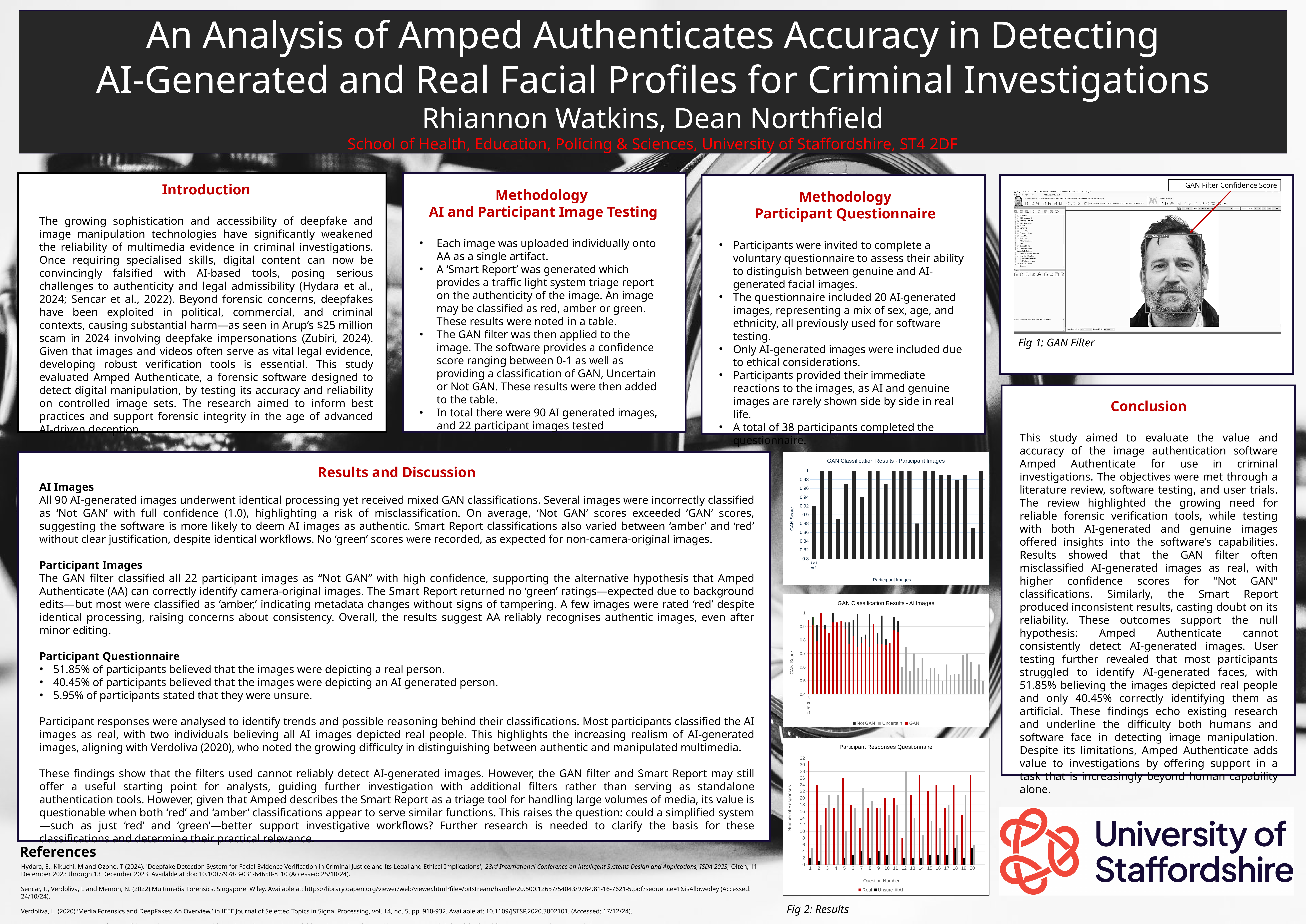
In the 'Participant Responses Questionnaire' chart, which question number has the highest 'Real' value? 1 In the 'Participant Responses Questionnaire' chart, is the 'Real' value for question 1 larger than the 'Real' value for question 2? Yes In the 'Participant Responses Questionnaire' chart, is the 'Unsure' value for question 12 greater or less than 20? less How many series does the legend of the 'GAN Classification Results - AI Images' chart list? 3 What kind of chart is the 'Participant Responses Questionnaire' chart? bar chart What are the legend entries of the 'Participant Responses Questionnaire' chart? Real, Unsure, AI What kind of chart is the 'GAN Classification Results - Participant Images' chart? bar chart In the 'Participant Responses Questionnaire' chart, is the 'AI' value for question 1 greater or less than 10? less What is the y-axis title of the 'GAN Classification Results - Participant Images' chart? GAN Score In the 'Participant Responses Questionnaire' chart, is the 'Real' value for question 1 greater or less than 28? greater How many question numbers are shown on the x axis of the 'Participant Responses Questionnaire' chart? 20 How many series does the legend of the 'Participant Responses Questionnaire' chart list? 3